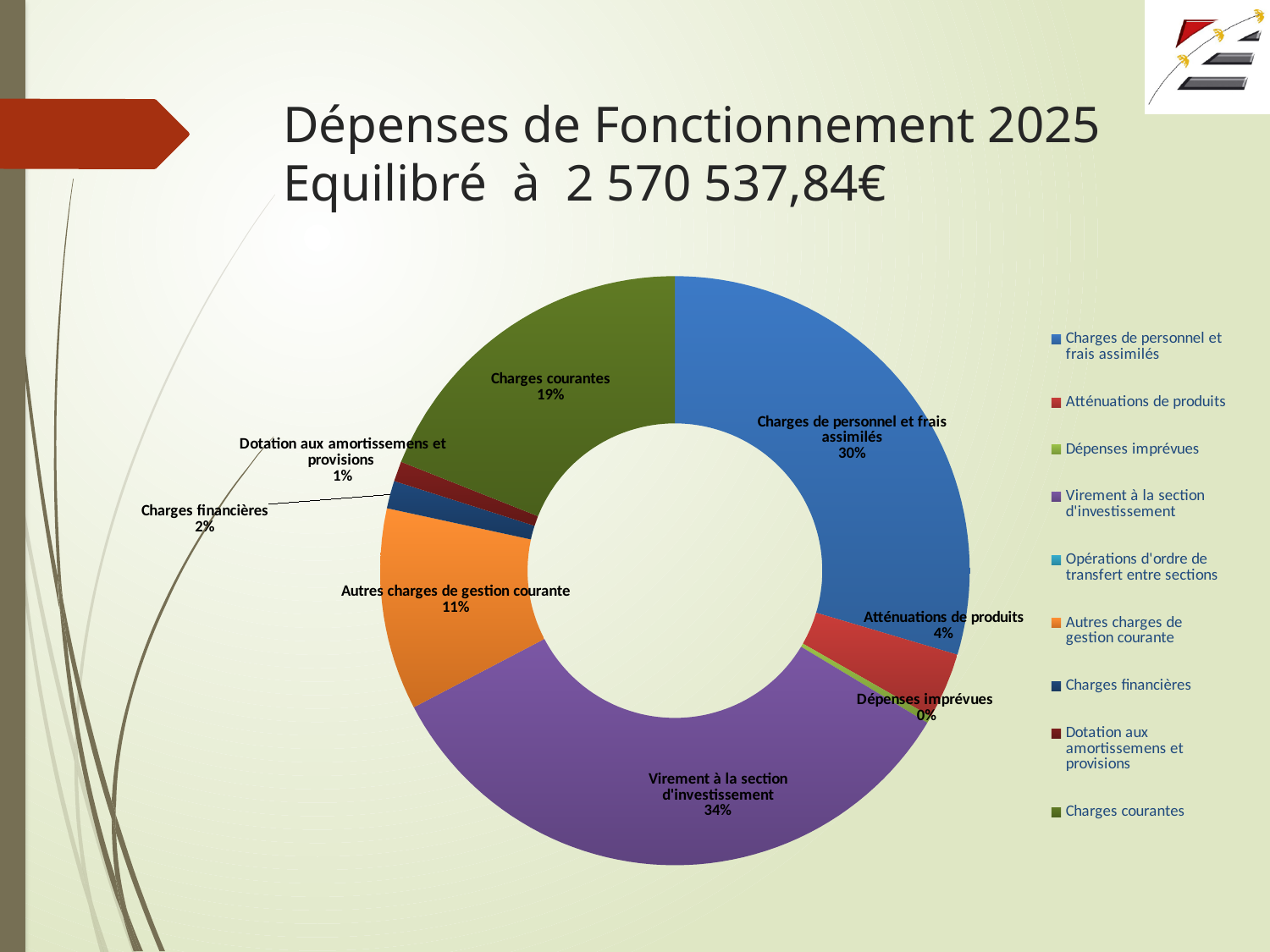
What percentage is shown for Charges de personnel et frais assimilés? 30% Which category has the largest share of the chart? Virement à la section d'investissement What percentage is shown for Charges courantes? 19% Which is larger, the share for Charges courantes or the share for Autres charges de gestion courante? Charges courantes What percentage is shown for Atténuations de produits? 4% What percentage is shown for Autres charges de gestion courante? 11% What is the difference in percentage points between Virement à la section d'investissement and Charges de personnel et frais assimilés? 4 percentage points How many entries does the legend list? 9 What percentage is shown for Charges financières? 2% What is the title of the slide containing the chart? Dépenses de Fonctionnement 2025 Equilibré à 2 570 537,84€ What share of the pie does Virement à la section d'investissement represent? 34% What kind of chart is shown on the slide? Doughnut (pie) chart